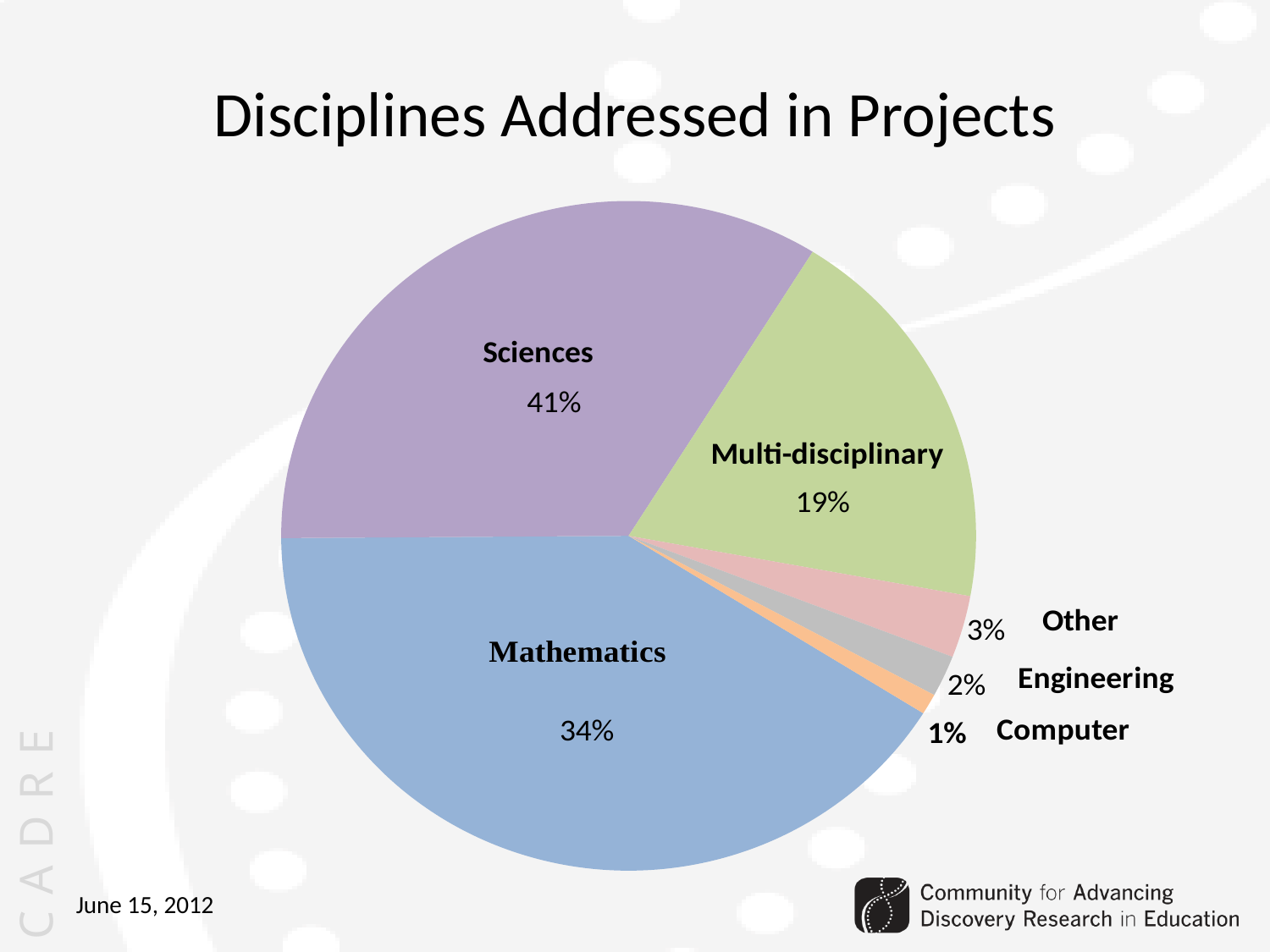
What is the title of the chart? Disciplines Addressed in Projects What share of the pie does Sciences represent? 41% What kind of chart is shown on the slide? pie chart What share of the pie does Multi-disciplinary represent? 19% What percentage is shown for Engineering? 2% What share of the pie does Mathematics represent? 34% How many slices does the pie chart have? 6 Which discipline has the largest slice of the pie? Sciences Which is larger, the Multi-disciplinary slice or the Other slice? Multi-disciplinary What is the difference in percentage points between Sciences and Mathematics? 7 What percentage is shown for Computer? 1% Which discipline has the smallest slice of the pie? Computer